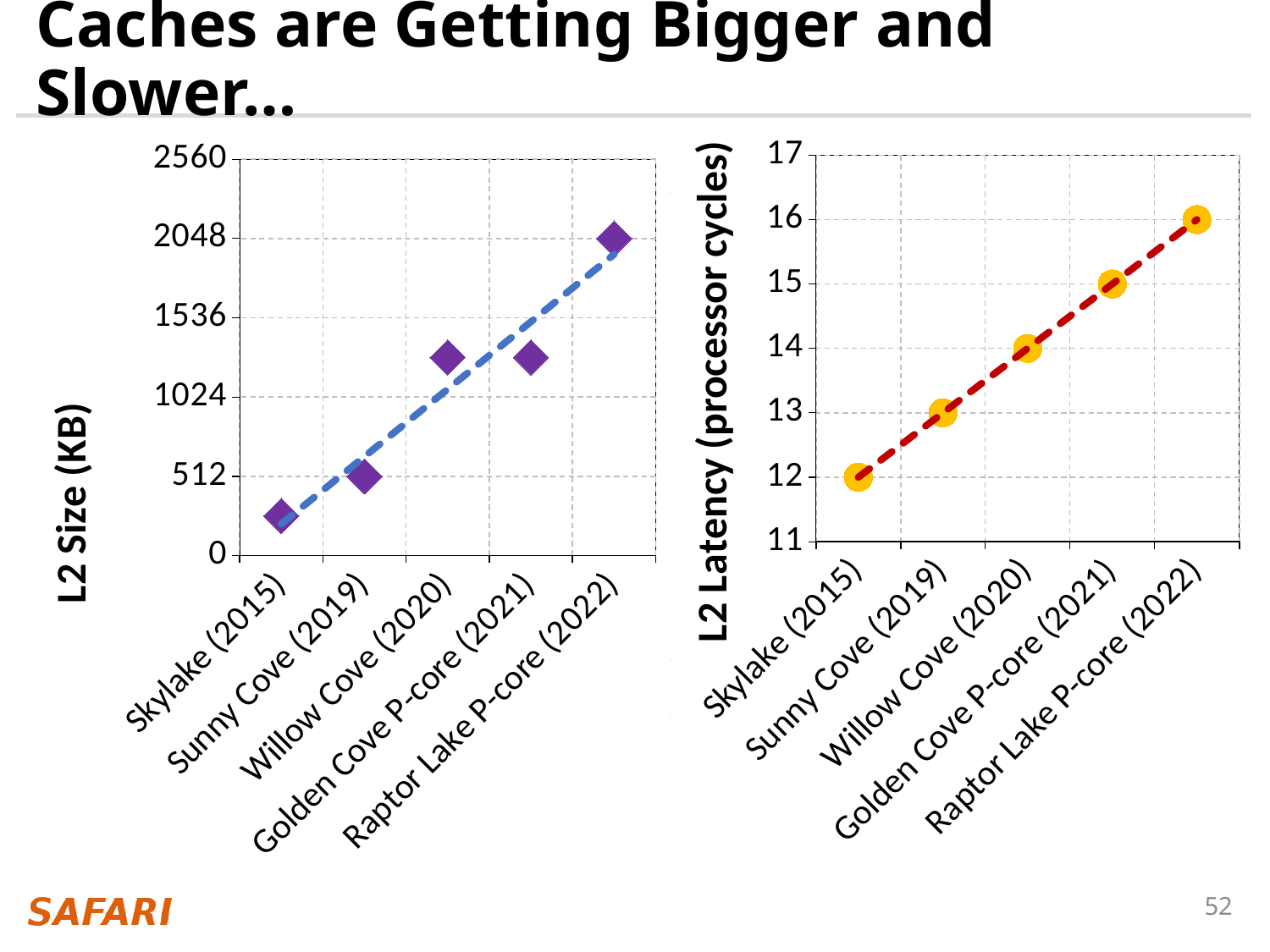
In the L2 Size (KB) chart, is the value for Willow Cove (2020) greater or less than 1024? greater In the L2 Latency (processor cycles) chart, do the values rise or fall from Skylake (2015) to Raptor Lake P-core (2022)? rise In the L2 Latency (processor cycles) chart, what is the L2 latency for Raptor Lake P-core (2022)? 16 In the L2 Latency (processor cycles) chart, what is the L2 latency for Skylake (2015)? 12 In the L2 Size (KB) chart, which processor has the largest L2 size? Raptor Lake P-core (2022) In the L2 Size (KB) chart, which processor has the smallest L2 size? Skylake (2015) In the L2 Size (KB) chart, is the value for Skylake (2015) greater or less than 512? less In the L2 Latency (processor cycles) chart, what is the L2 latency for Willow Cove (2020)? 14 In the L2 Size (KB) chart, what is the L2 size for Raptor Lake P-core (2022)? 2048 In the L2 Size (KB) chart, what is the L2 size for Sunny Cove (2019)? 512 How many processors are plotted in the L2 Latency (processor cycles) chart? 5 In the L2 Latency (processor cycles) chart, what is the difference in latency between Raptor Lake P-core (2022) and Skylake (2015)? 4